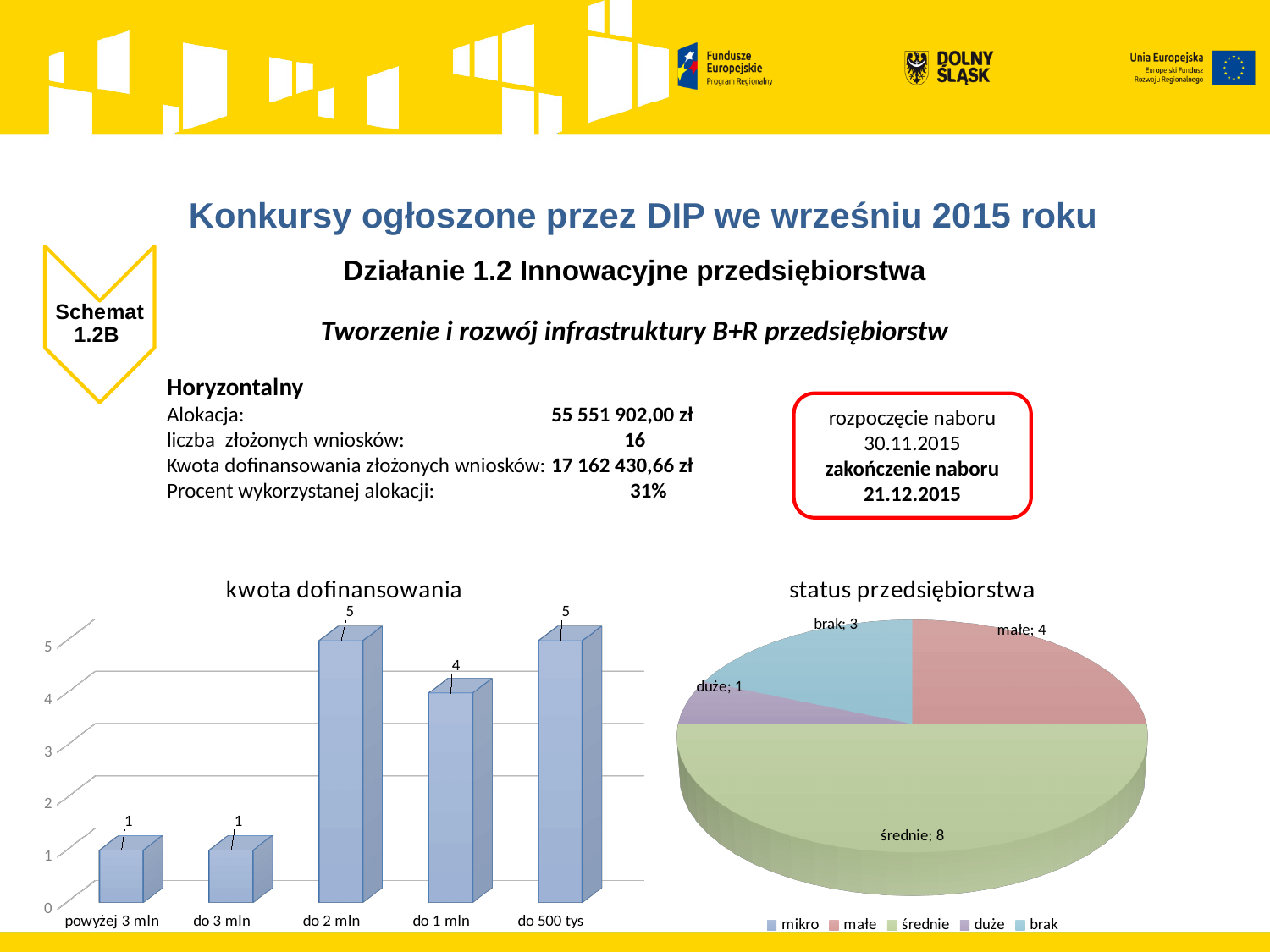
What kind of chart is the 'kwota dofinansowania' chart? bar chart In the 'status przedsiębiorstwa' chart, which labelled category has the lowest value? duże In the 'kwota dofinansowania' chart, what is the value for 'powyżej 3 mln'? 1 How many entries does the legend of the 'status przedsiębiorstwa' chart list? 5 In the 'status przedsiębiorstwa' chart, what is the difference between the values for 'małe' and 'duże'? 3 In the 'kwota dofinansowania' chart, what is the value for 'do 2 mln'? 5 How many categories are shown on the x axis of the 'kwota dofinansowania' chart? 5 In the 'status przedsiębiorstwa' chart, what is the value for 'brak'? 3 In the 'kwota dofinansowania' chart, what is the value for 'do 1 mln'? 4 In the 'status przedsiębiorstwa' chart, what is the value for 'średnie'? 8 In the 'kwota dofinansowania' chart, what is the difference between the values for 'do 2 mln' and 'do 1 mln'? 1 In the 'kwota dofinansowania' chart, which is larger: the value for 'do 1 mln' or the value for 'do 3 mln'? do 1 mln